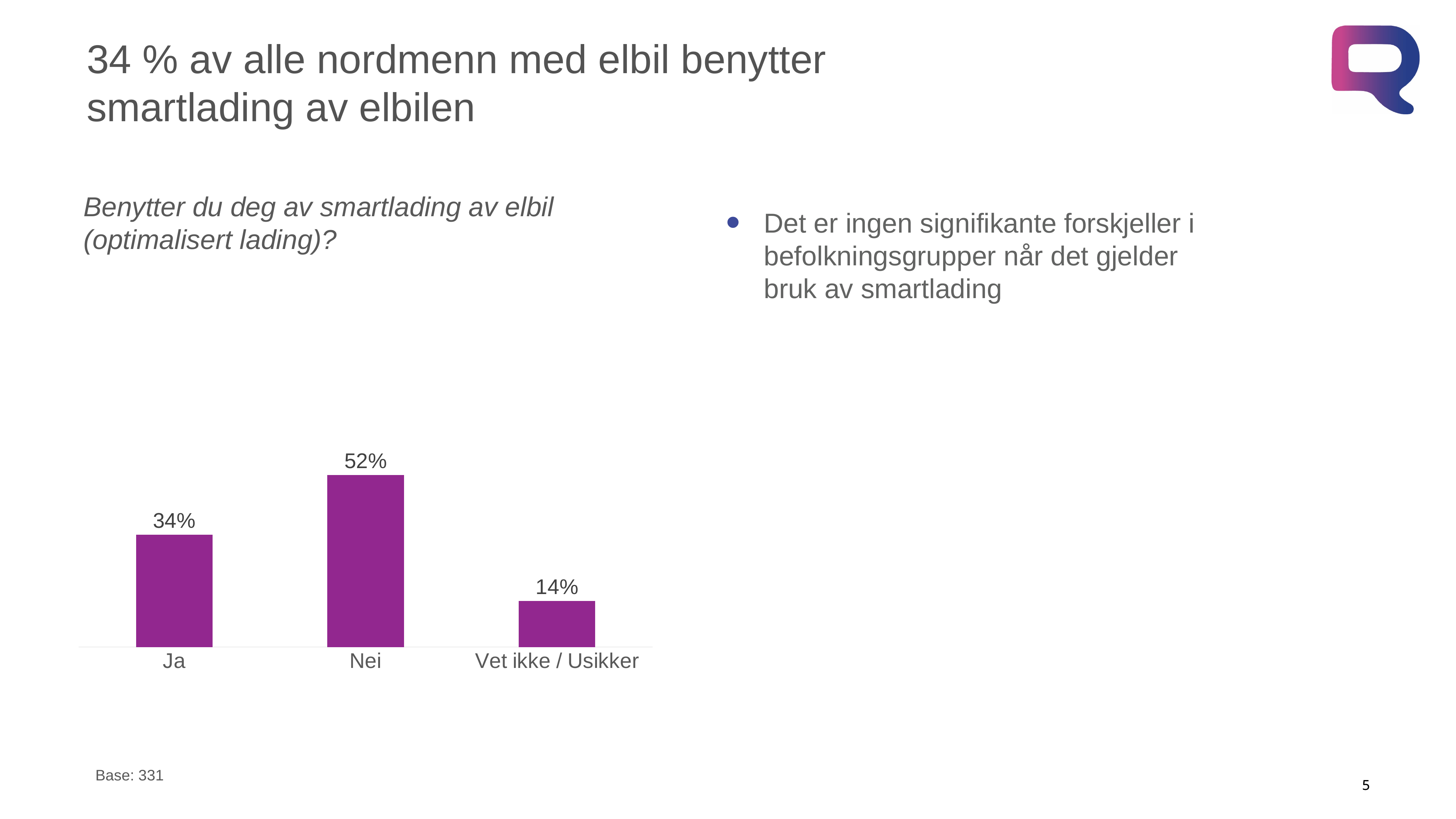
What is the difference between the values for Ja and Vet ikke / Usikker? 20% What is the difference between the values for Nei and Ja? 18% Which category has the lowest value? Vet ikke / Usikker What is the value for Nei? 52% What is the value for Vet ikke / Usikker? 14% What colour are the bars in the chart? Purple What is the base (number of respondents) stated below the chart? 331 What kind of chart is shown on the slide? Bar chart What is the value for Ja? 34% How many categories are shown in the chart? 3 Which category has the highest value? Nei Which is larger, the value for Ja or the value for Nei? Nei